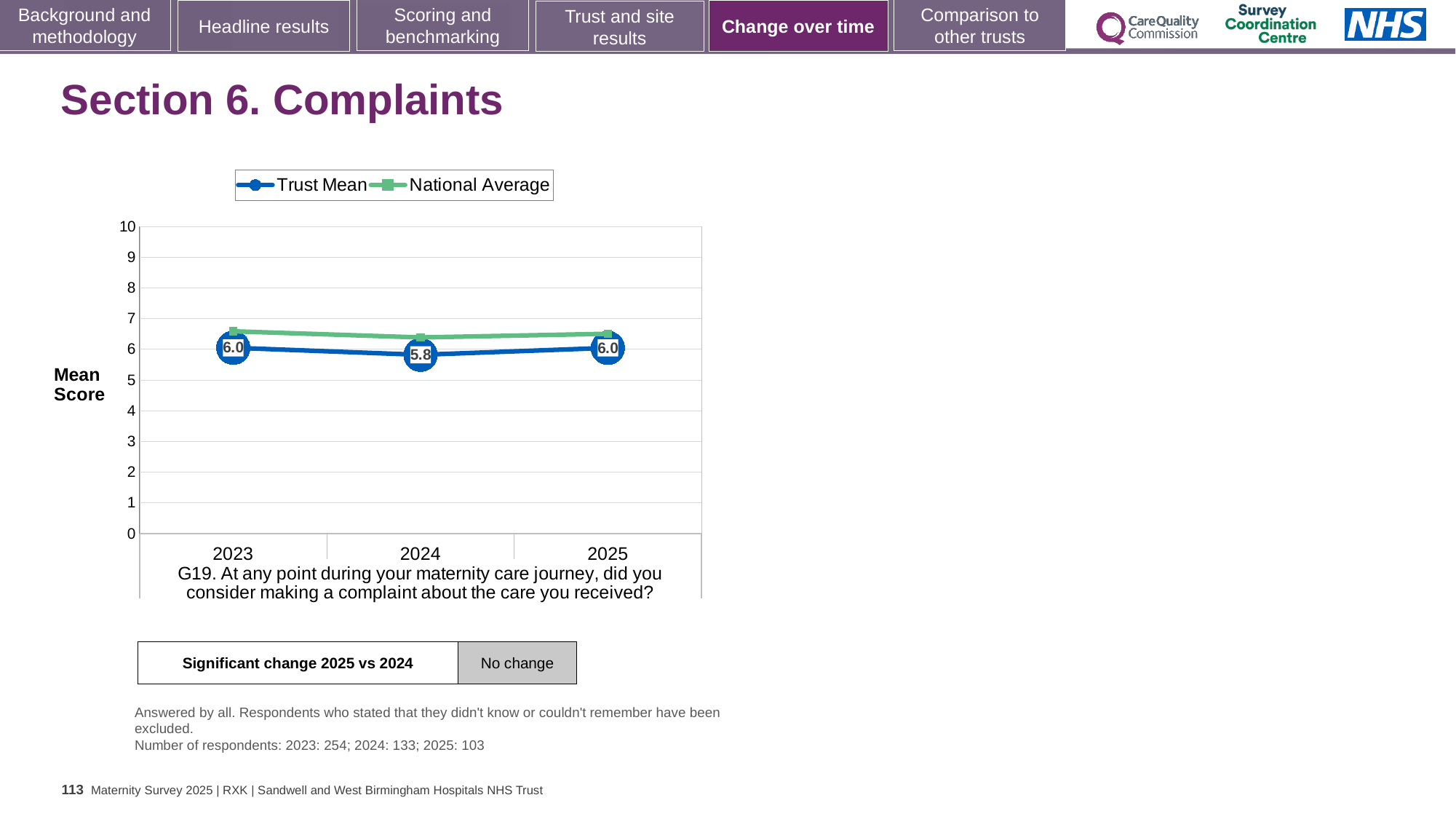
What is the Trust Mean value for 2025? 6.0 Which is larger, the Trust Mean in 2023 or the Trust Mean in 2024? 2023 In 2023, which series is higher, Trust Mean or National Average? National Average Is the National Average value for 2023 greater or less than 6? greater How many years are plotted on the x axis? 3 In which year is the Trust Mean lowest? 2024 How many series does the legend list? 2 What is the Trust Mean value for 2024? 5.8 What is the difference between the Trust Mean in 2023 and in 2024? 0.2 What kind of chart is shown on the slide? Line chart What is the Trust Mean value for 2023? 6.0 Is the National Average value for 2023 greater or less than 7? less